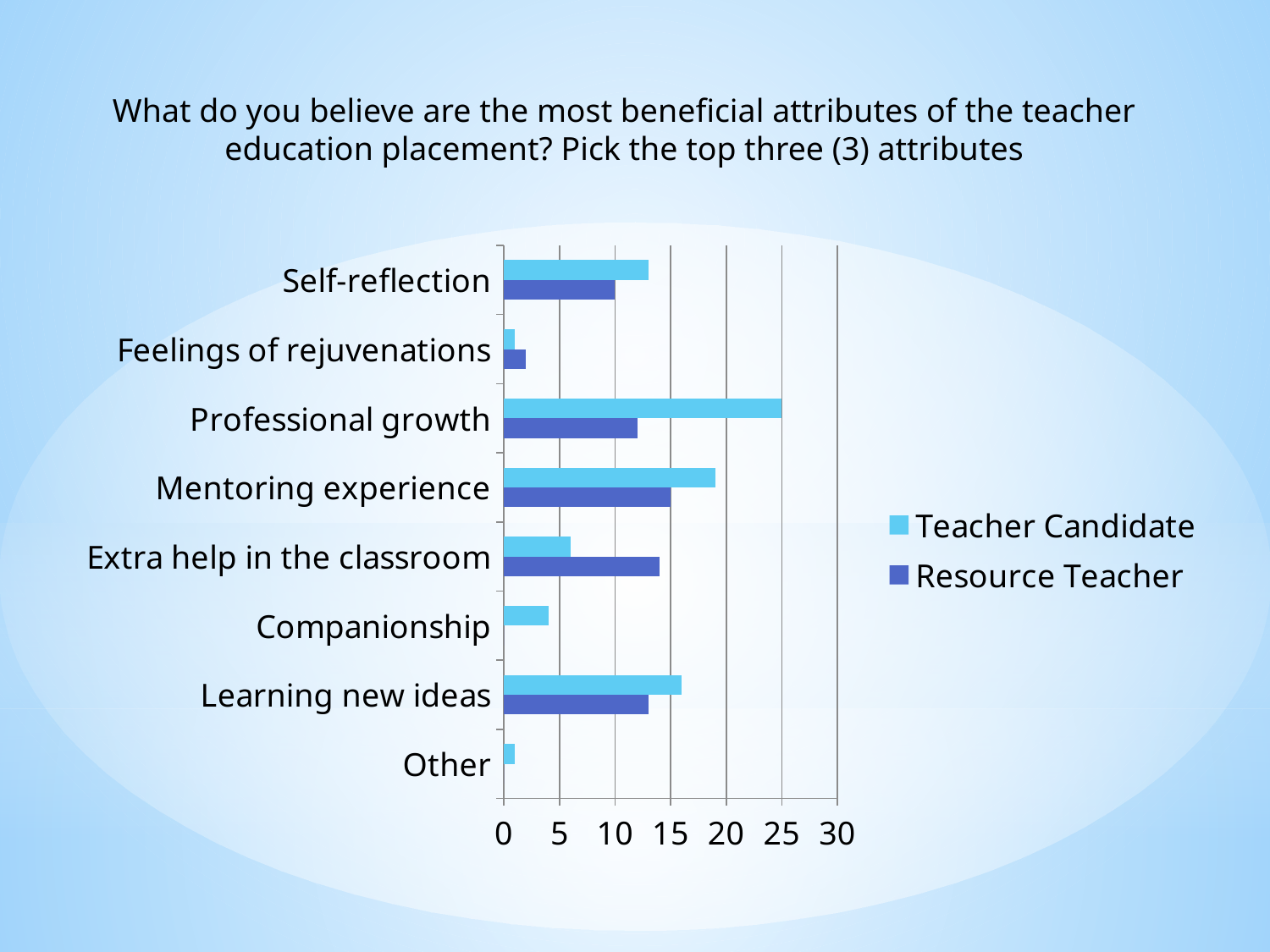
For Extra help in the classroom, which series has the larger value, Teacher Candidate or Resource Teacher? Resource Teacher Is the Teacher Candidate value for Companionship greater or less than 5? less Is the Teacher Candidate value for Learning new ideas greater or less than 15? greater What is the Teacher Candidate value for Professional growth? 25 Which series is shown in the darker blue colour? Resource Teacher How many series does the legend list? 2 What kind of chart is shown on the slide? bar chart What is the highest value shown on the horizontal axis? 30 How many attribute categories are plotted on the chart? 8 For Professional growth, which series has the larger value, Teacher Candidate or Resource Teacher? Teacher Candidate Is the Resource Teacher value for Extra help in the classroom greater or less than 10? greater Which attribute has the highest value for Teacher Candidate? Professional growth